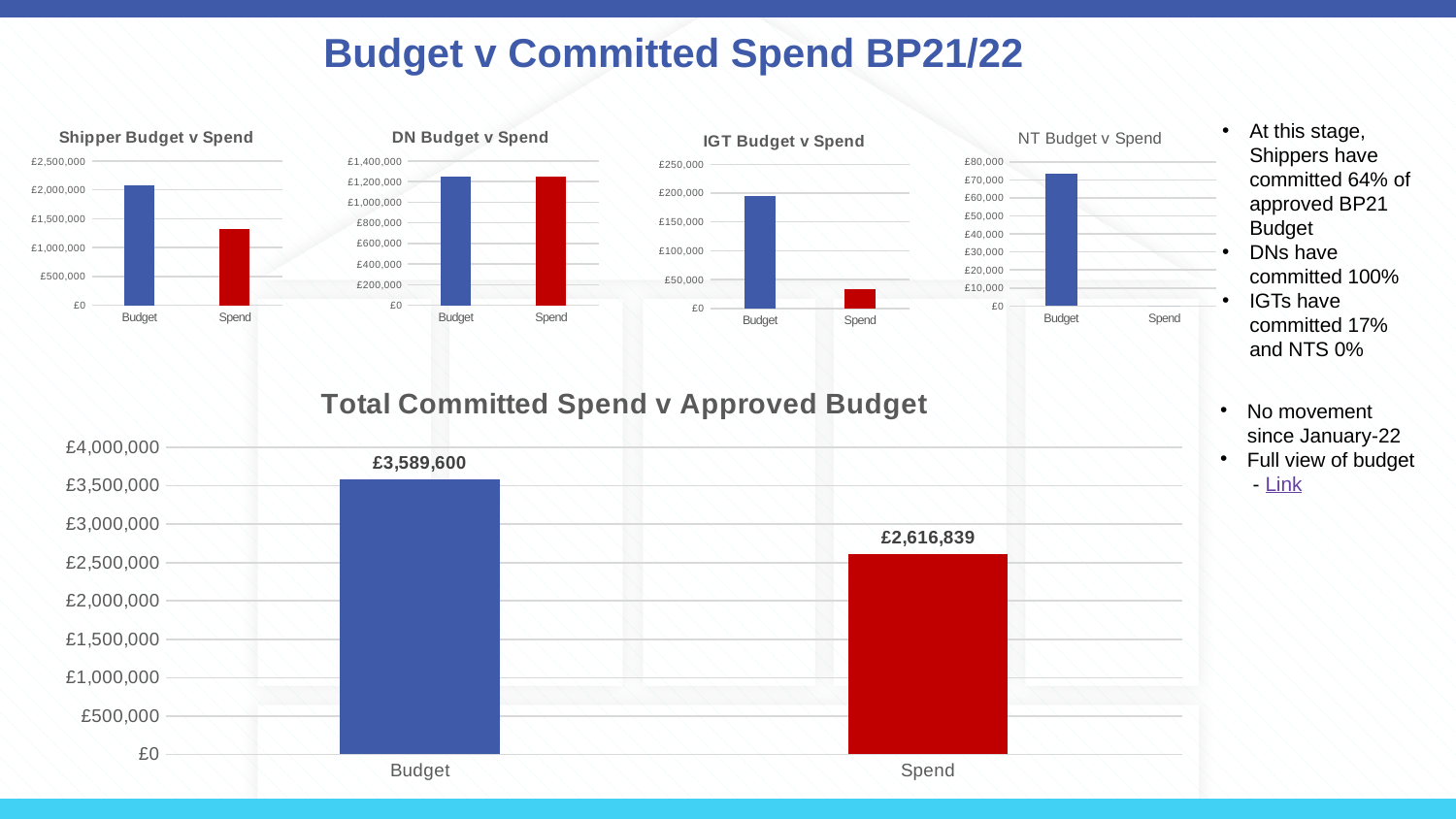
On the Total Committed Spend v Approved Budget chart, what is the value of the Spend bar? £2,616,839 On the Shipper Budget v Spend chart, is the value for Spend greater or less than £1,000,000? greater What kind of chart is the Total Committed Spend v Approved Budget chart? Bar chart How many categories are shown on the x axis of the Total Committed Spend v Approved Budget chart? 2 On the IGT Budget v Spend chart, which bar is higher, Budget or Spend? Budget On the Total Committed Spend v Approved Budget chart, what is the value of the Budget bar? £3,589,600 On the DN Budget v Spend chart, is the value for Budget greater or less than £1,000,000? greater On the IGT Budget v Spend chart, is the value for Spend greater or less than £50,000? less On the Total Committed Spend v Approved Budget chart, what is the difference between the Budget and Spend values? £972,761 On the Total Committed Spend v Approved Budget chart, which bar is higher, Budget or Spend? Budget